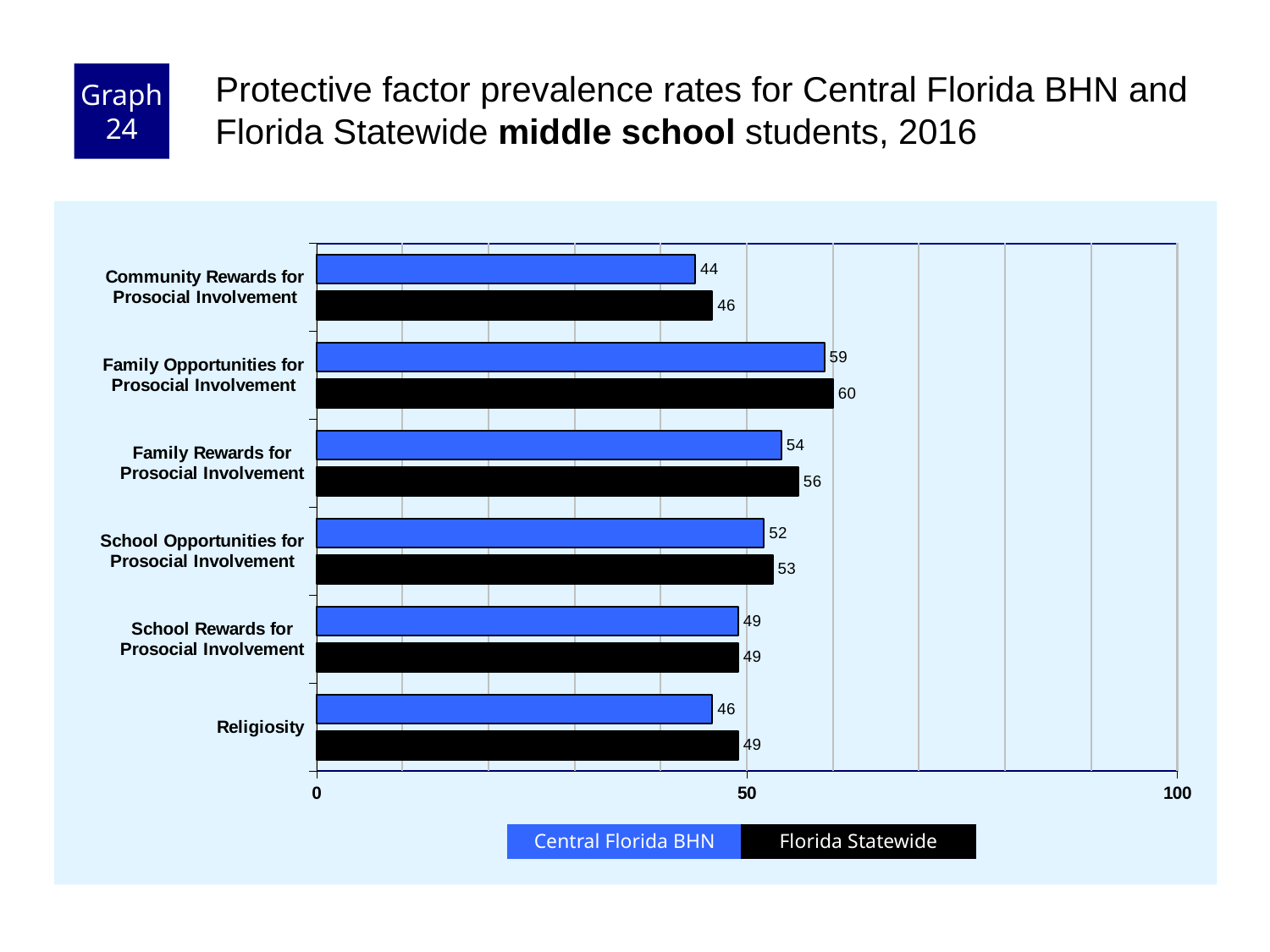
What is the difference between the Florida Statewide and Central Florida BHN values for Family Rewards for Prosocial Involvement? 2 How many series does the legend list? 2 What is the difference between the Florida Statewide and Central Florida BHN values for Religiosity? 3 What is the Central Florida BHN value for Family Opportunities for Prosocial Involvement? 59 Is the Central Florida BHN value for Community Rewards for Prosocial Involvement greater or less than 50? less How many categories are shown on the chart? 6 Which is larger for School Opportunities for Prosocial Involvement: the Central Florida BHN value or the Florida Statewide value? Florida Statewide What is the Florida Statewide value for Community Rewards for Prosocial Involvement? 46 Which category has the highest Central Florida BHN value? Family Opportunities for Prosocial Involvement What kind of chart is shown on the slide? bar chart What is the Florida Statewide value for Religiosity? 49 Which category has the lowest Central Florida BHN value? Community Rewards for Prosocial Involvement